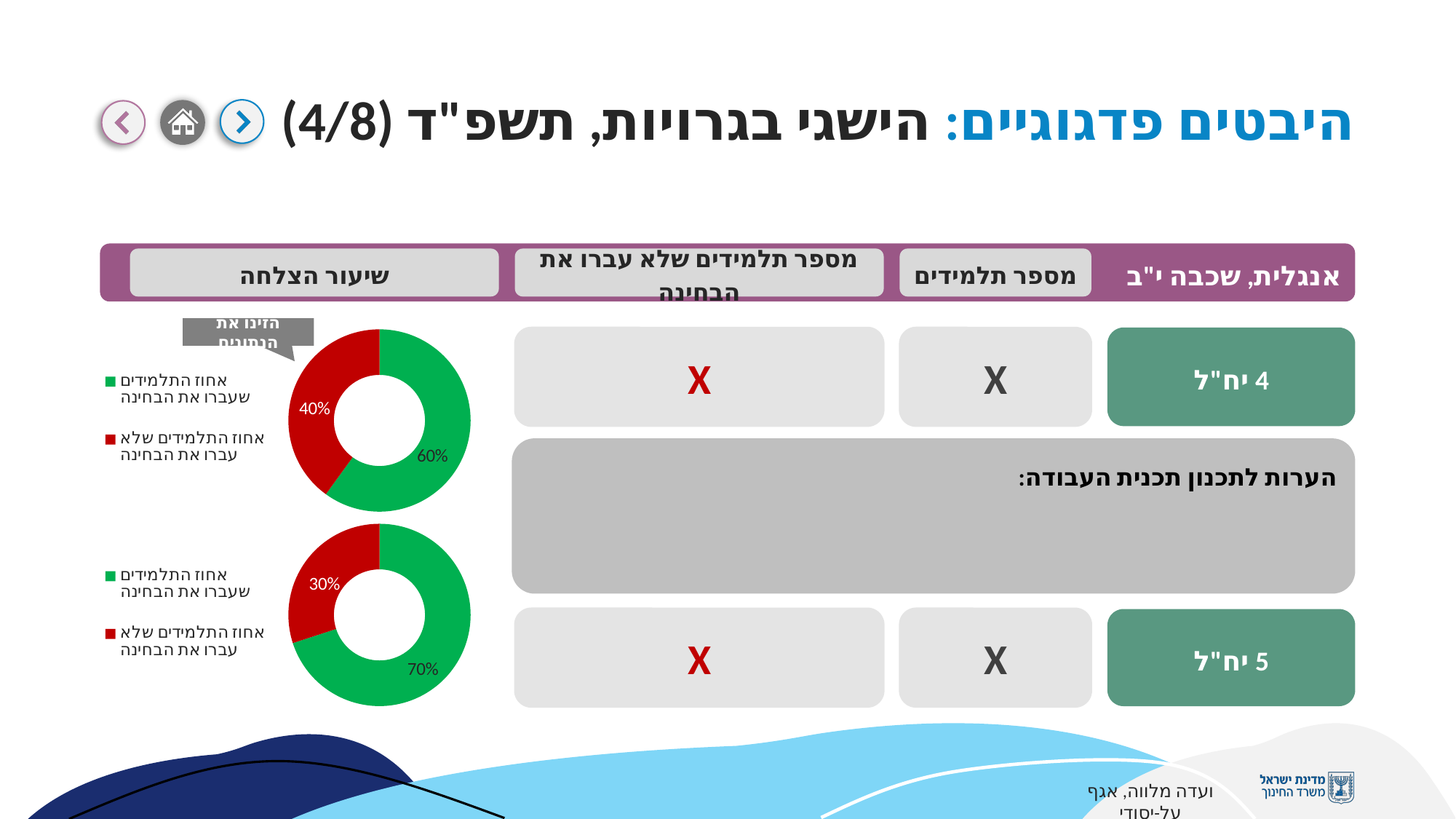
How many legend entries are listed next to each donut chart? 2 In the bottom donut chart, what is the difference between the passed and not-passed percentages? 40% In the donut charts, which colour represents students who passed the exam? Green In the top donut chart, what is the difference between the passed and not-passed percentages? 20% How many slices does each donut chart on the slide have? 2 What type of chart is used to show the success rate (שיעור הצלחה) on this slide? Donut (pie) chart In the bottom donut chart (5 יח"ל row), what percentage of students passed the exam (green slice)? 70% In the bottom donut chart (5 יח"ל row), what percentage of students did not pass the exam (red slice)? 30% In the top donut chart, which slice is larger: students who passed or students who did not pass? Students who passed (60%) In the top donut chart (4 יח"ל row), what percentage of students did not pass the exam (red slice)? 40% In the top donut chart (4 יח"ל row), what percentage of students passed the exam (green slice)? 60% In the bottom donut chart, which slice is the smallest? אחוז התלמידים שלא עברו את הבחינה (30%)